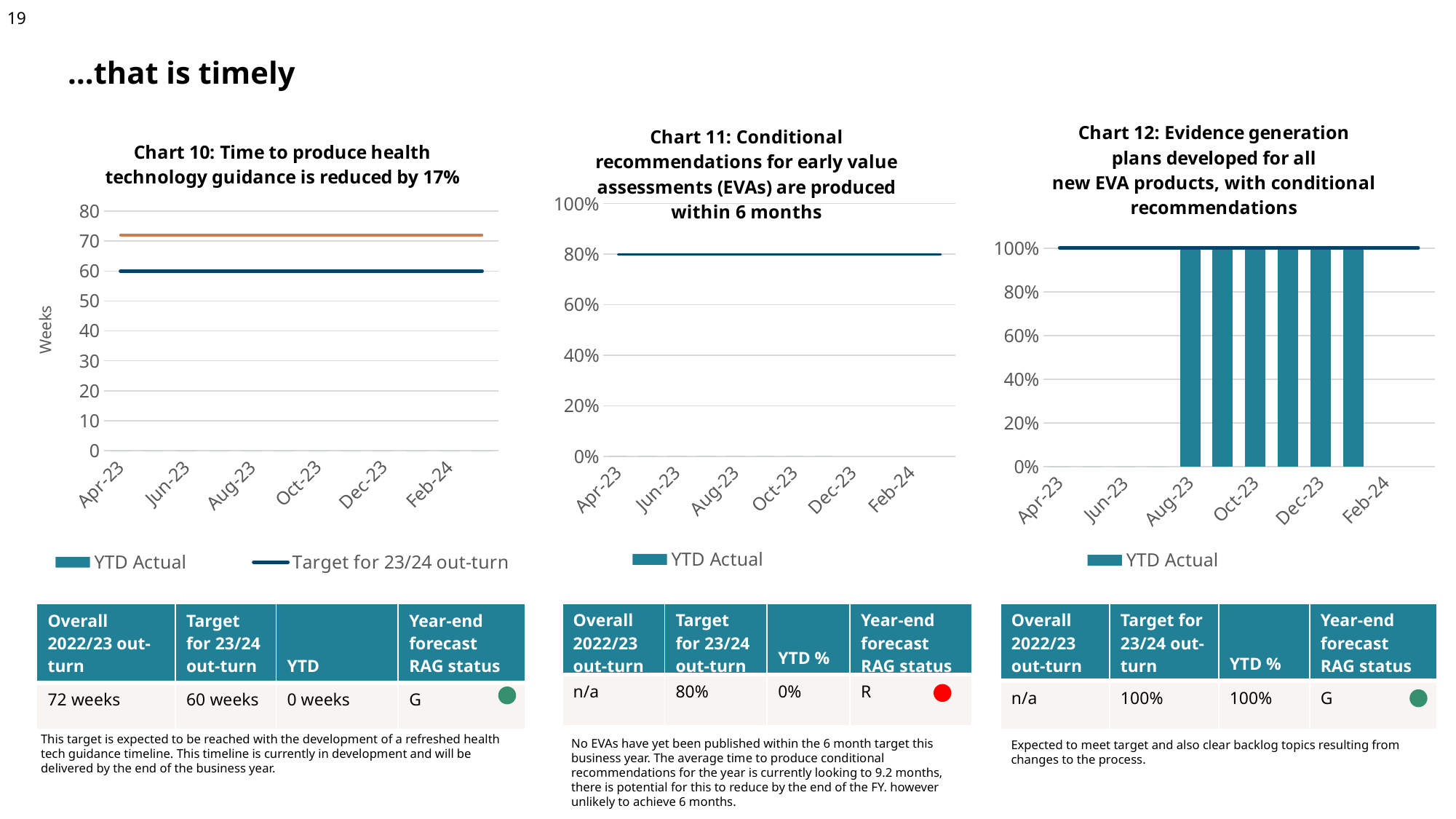
What is the legend entry shown under Chart 12: Evidence generation plans developed for all new EVA products? YTD Actual In Chart 11: Conditional recommendations for early value assessments (EVAs) are produced within 6 months, at what value does the horizontal line sit? 80% How many series does the legend of Chart 11 list? 1 How many bars are plotted in Chart 12? 6 What is the label on the vertical axis of Chart 10? Weeks In Chart 10, which line is higher, the orange line or the dark blue line? the orange line In Chart 10, is the orange line greater or less than 70 weeks? greater In Chart 10, at what value on the Weeks axis does the dark blue line sit? 60 What kind of chart is Chart 10: Time to produce health technology guidance is reduced by 17%? line chart In Chart 12, what is the value of the bar at Oct-23? 100% How many series does the legend of Chart 10 list? 2 In Chart 12, is the value of the bar at Aug-23 greater or less than 80%? greater